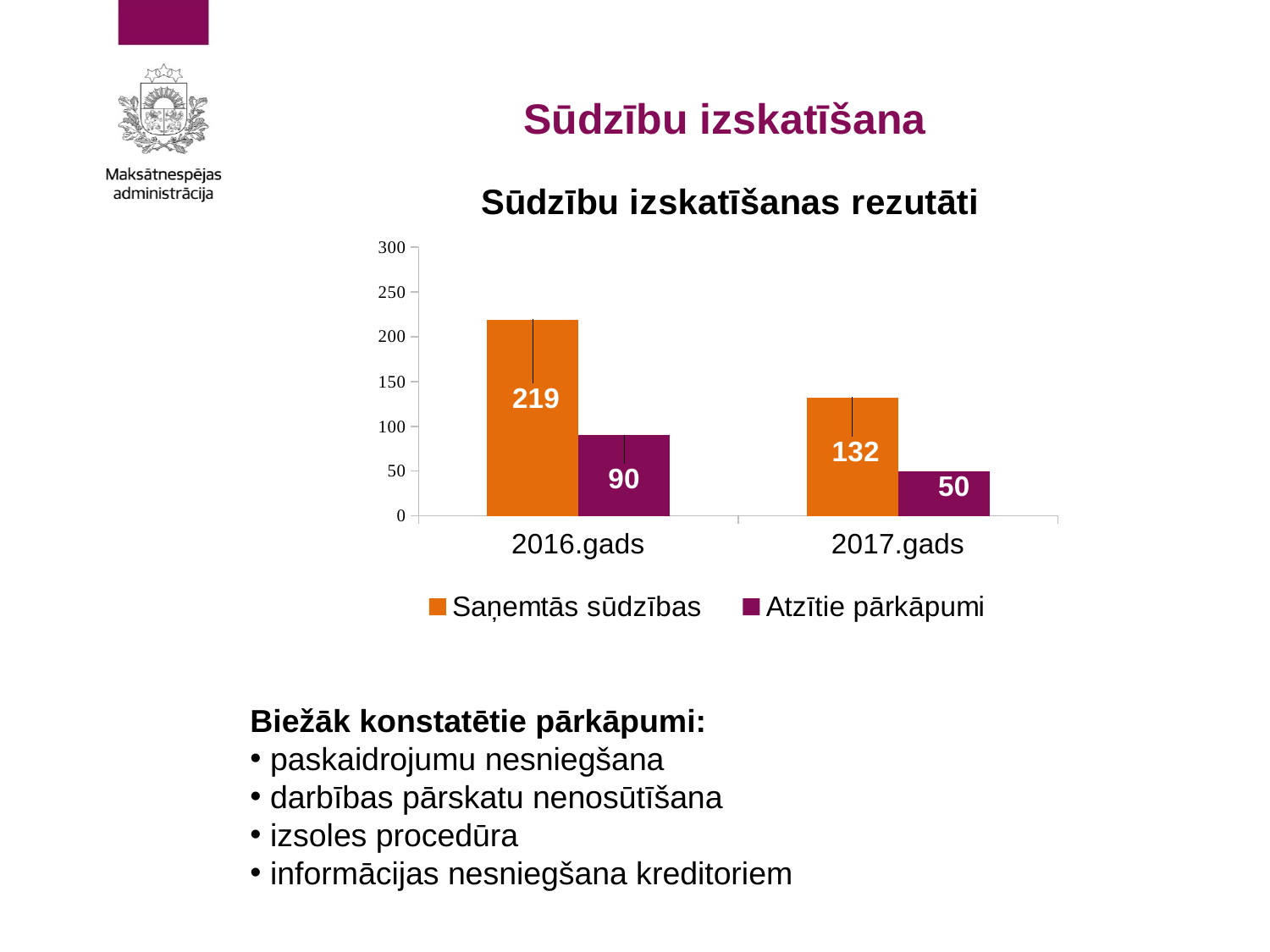
Which year has the lowest value for Atzītie pārkāpumi? 2017.gads What is the value of Saņemtās sūdzības for 2016.gads? 219 How many series does the legend list? 2 Which is larger in 2017.gads: Saņemtās sūdzības or Atzītie pārkāpumi? Saņemtās sūdzības What is the value of Atzītie pārkāpumi for 2017.gads? 50 What kind of chart is shown on the slide? Bar chart What is the value of Atzītie pārkāpumi for 2016.gads? 90 Which year has the highest value for Saņemtās sūdzības? 2016.gads What is the title of the chart? Sūdzību izskatīšanas rezutāti What is the value of Saņemtās sūdzības for 2017.gads? 132 What is the difference between Saņemtās sūdzības and Atzītie pārkāpumi in 2016.gads? 129 What is the difference between Saņemtās sūdzības in 2016.gads and 2017.gads? 87